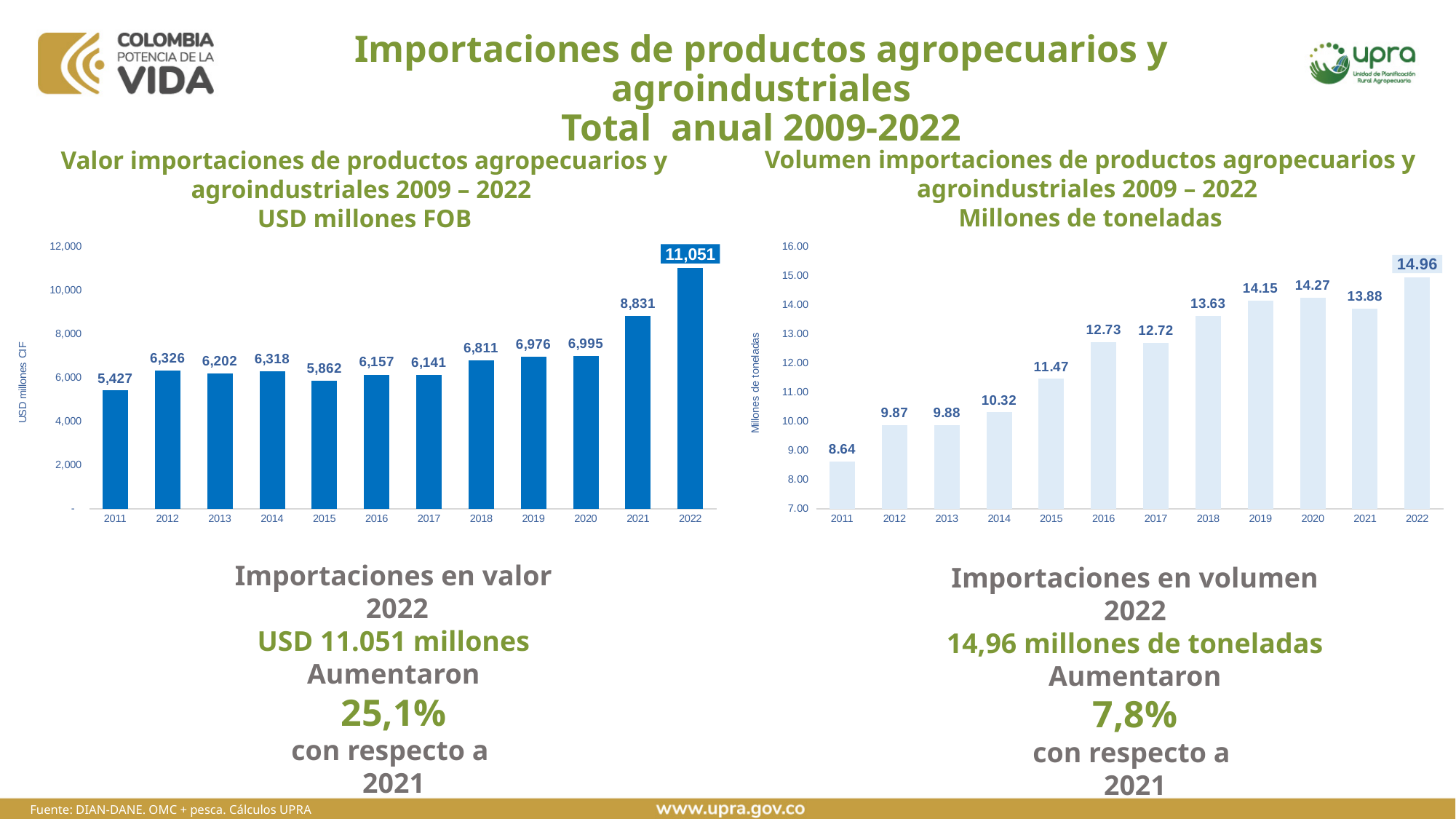
In the left chart (Valor importaciones, USD millones FOB), how many years are plotted? 12 In the left chart (Valor importaciones, USD millones FOB), what is the value for 2022? 11,051 In the left chart (Valor importaciones, USD millones FOB), what is the difference between the 2022 and 2021 values? 2,220 In the right chart (Volumen importaciones, Millones de toneladas), which year has the highest value? 2022 In the right chart (Volumen importaciones, Millones de toneladas), what is the value for 2016? 12.73 In the left chart (Valor importaciones, USD millones FOB), is the value for 2021 greater or less than 8,000? greater In the left chart (Valor importaciones, USD millones FOB), what is the value for 2015? 5,862 What is the y-axis label of the left chart (Valor importaciones, USD millones FOB)? USD millones CIF In the right chart (Volumen importaciones, Millones de toneladas), what is the difference between the 2022 and 2011 values? 6.32 In the right chart (Volumen importaciones, Millones de toneladas), which is larger, the value for 2020 or the value for 2021? 2020 What type of chart is the right chart (Volumen importaciones, Millones de toneladas)? bar chart In the left chart (Valor importaciones, USD millones FOB), which year has the lowest value? 2011